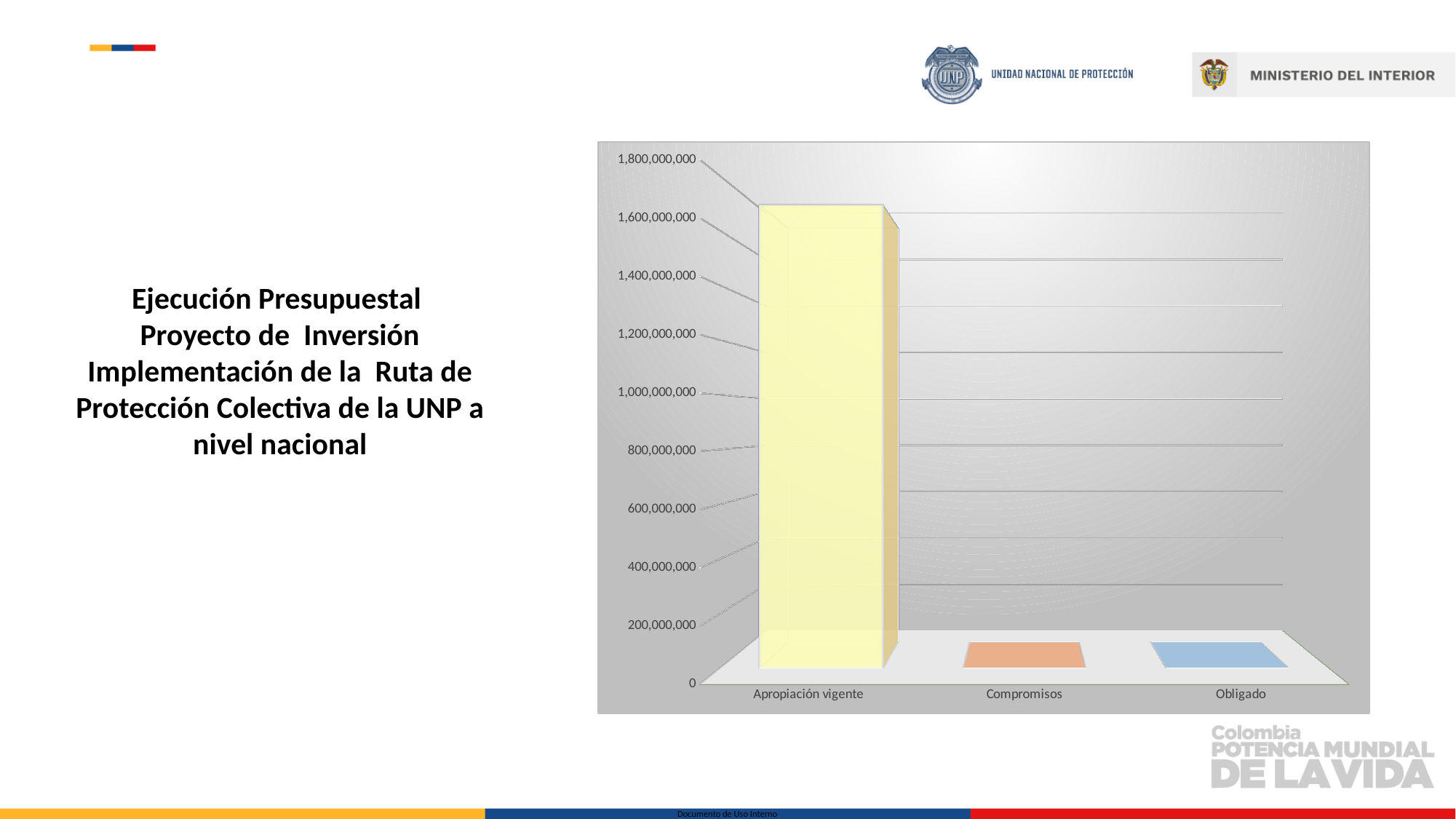
What colour is the bar for Apropiación vigente? yellow What kind of chart is shown on the slide? bar chart What is the highest tick value shown on the vertical axis of the chart? 1,800,000,000 Is the value for Apropiación vigente greater or less than 1,800,000,000? less Which category has the highest value in the chart? Apropiación vigente Is the value for Obligado greater or less than 200,000,000? less Which is larger, the value for Apropiación vigente or the value for Compromisos? Apropiación vigente Is the value for Compromisos greater or less than 200,000,000? less Which is larger, the value for Obligado or the value for Apropiación vigente? Apropiación vigente How many categories are shown on the x axis of the chart? 3